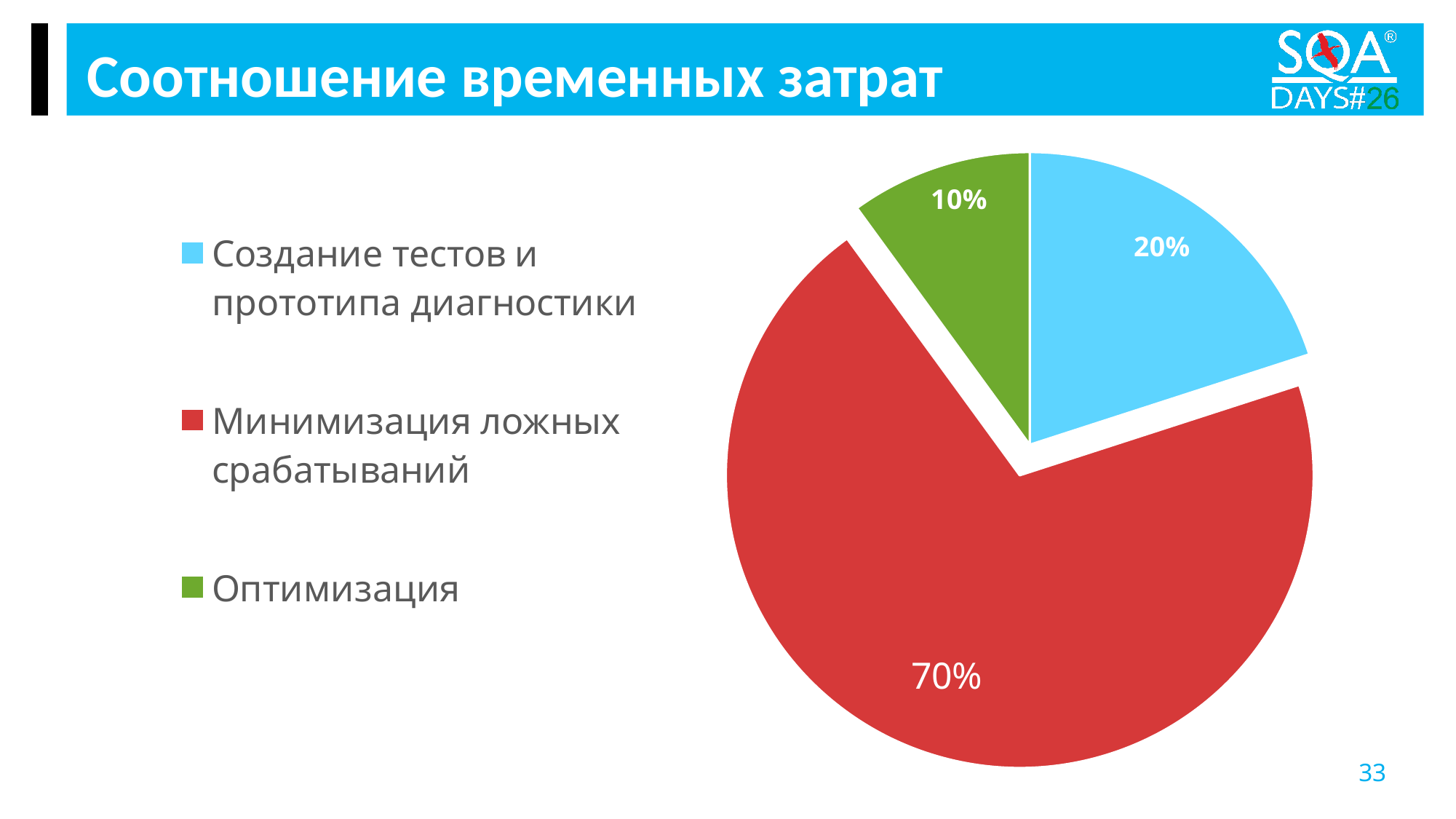
What colour is the slice for "Оптимизация"? Green What share of the pie does "Создание тестов и прототипа диагностики" take? 20% Which category has the largest slice of the pie? Минимизация ложных срабатываний What is the difference between the shares of "Создание тестов и прототипа диагностики" and "Оптимизация"? 10% What share of the pie does "Минимизация ложных срабатываний" take? 70% How many slices does the pie chart have? 3 Which is larger: the share for "Создание тестов и прототипа диагностики" or the share for "Оптимизация"? Создание тестов и прототипа диагностики What kind of chart is shown on the slide? Pie chart What share of the pie does "Оптимизация" take? 10% What is the difference between the shares of "Минимизация ложных срабатываний" and "Создание тестов и прототипа диагностики"? 50% What is the title of the slide containing the chart? Соотношение временных затрат Which category has the smallest slice of the pie? Оптимизация